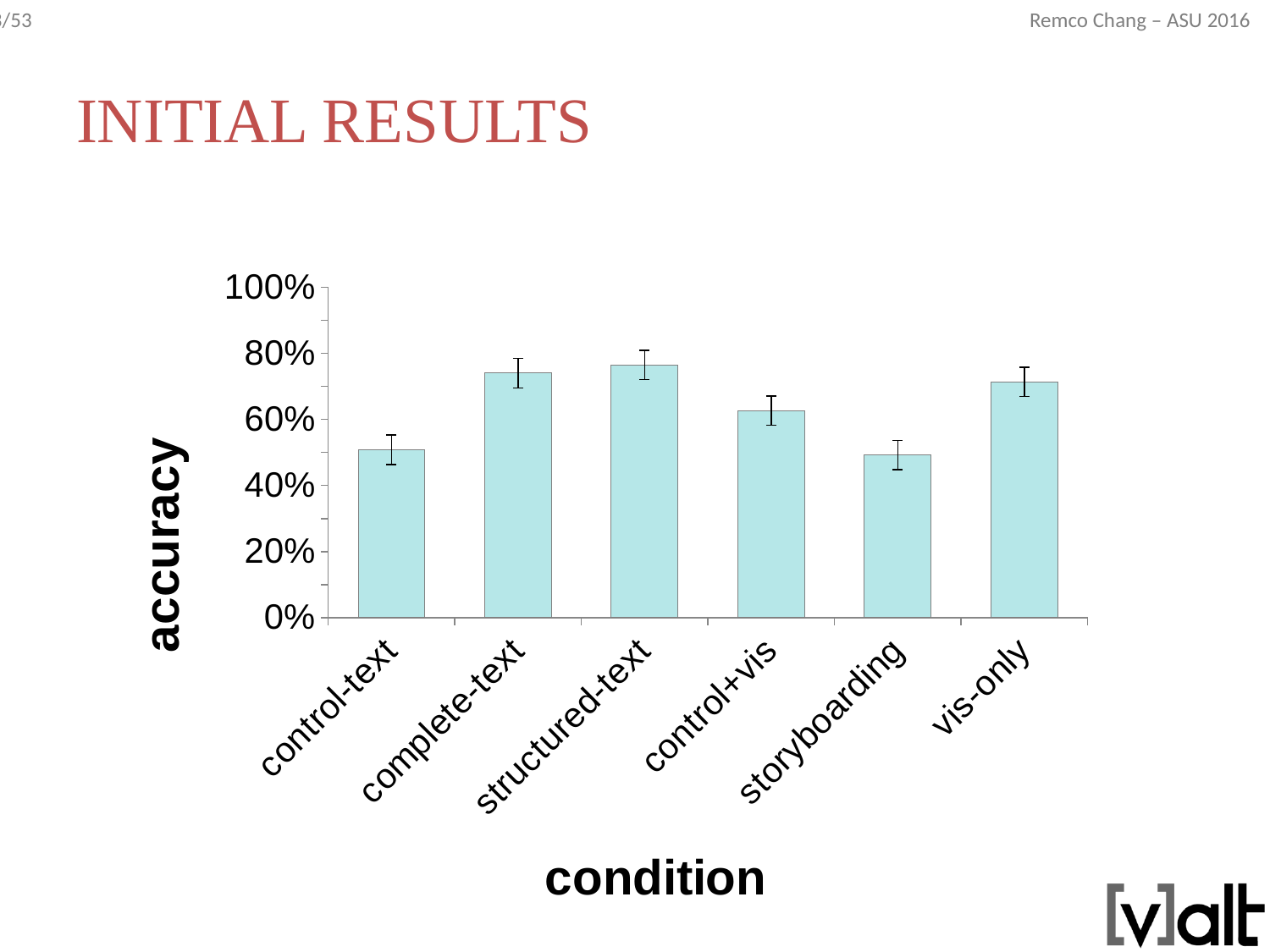
Is the accuracy for structured-text greater or less than 80%? less What is the label on the y axis of the chart? accuracy Is the accuracy for control-text greater or less than 60%? less Is the accuracy for storyboarding greater or less than 40%? greater What kind of chart is shown on the slide? bar chart How many conditions are plotted on the x axis? 6 Which has higher accuracy, vis-only or storyboarding? vis-only Which has higher accuracy, complete-text or control-text? complete-text Which has higher accuracy, structured-text or control+vis? structured-text